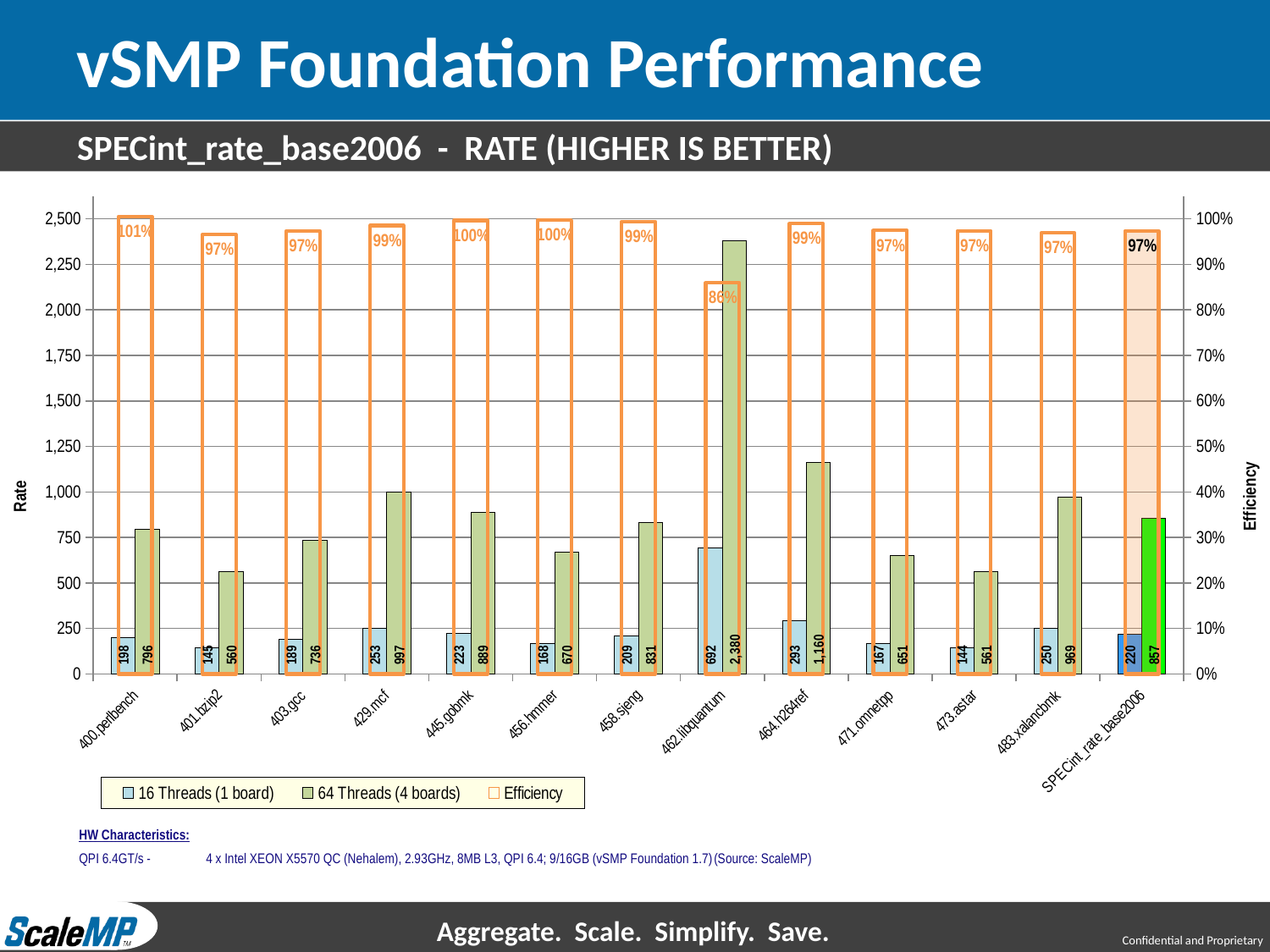
What is the difference between the 64 Threads and 16 Threads rates for 464.h264ref? 867 What is the 64 Threads (4 boards) rate for 462.libquantum? 2,380 Which has a higher 64 Threads (4 boards) rate, 429.mcf or 483.xalancbmk? 429.mcf Which benchmark has the highest 64 Threads (4 boards) rate? 462.libquantum Which benchmark has the highest efficiency? 400.perlbench How many series does the legend list? 3 What efficiency percentage is shown for 462.libquantum? 86% Which benchmark has the lowest efficiency? 462.libquantum What is the 64 Threads (4 boards) rate for SPECint_rate_base2006? 857 What is the 16 Threads (1 board) rate for 429.mcf? 253 What type of chart is shown on the slide? Bar chart How many categories are shown on the x axis? 13